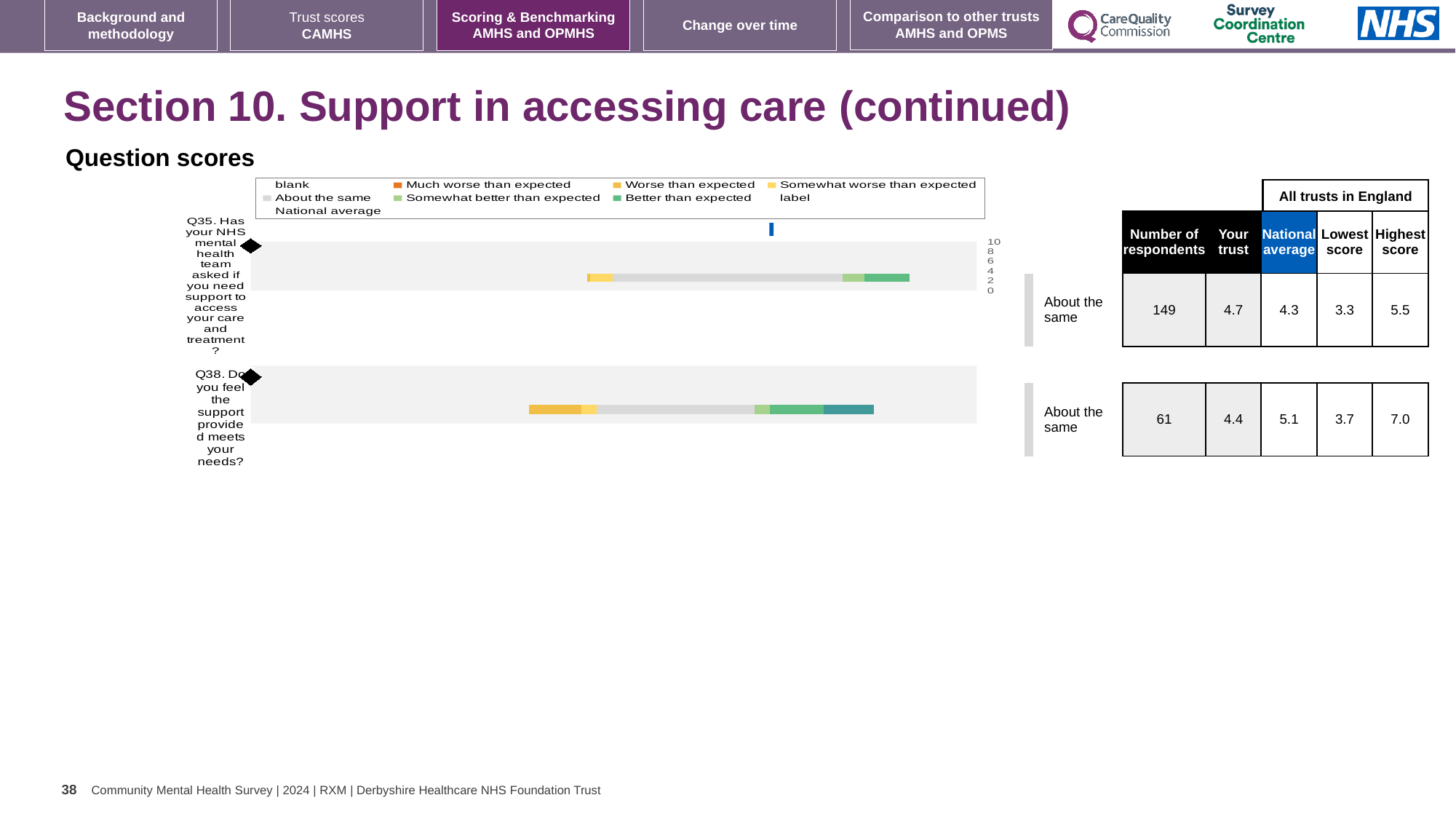
What benchmark category is shown for Q38? About the same How many more respondents answered Q35 than Q38? 88 What is the 'Your trust' score for Q35 (Has your NHS mental health team asked if you need support to access your care and treatment?)? 4.7 For Q38, which is larger: the trust's score or the national average? National average What kind of chart is used to show the question scores? Bar chart How many questions are plotted in the question scores chart? 2 What is the highest score among all trusts in England for Q38? 7.0 What is the difference between the highest and lowest scores for Q35? 2.2 What is the lowest score among all trusts in England for Q35? 3.3 What is the national average score for Q38 (Do you feel the support provided meets your needs?)? 5.1 How many respondents answered Q35? 149 For Q35, which is larger: the trust's score or the national average? Your trust